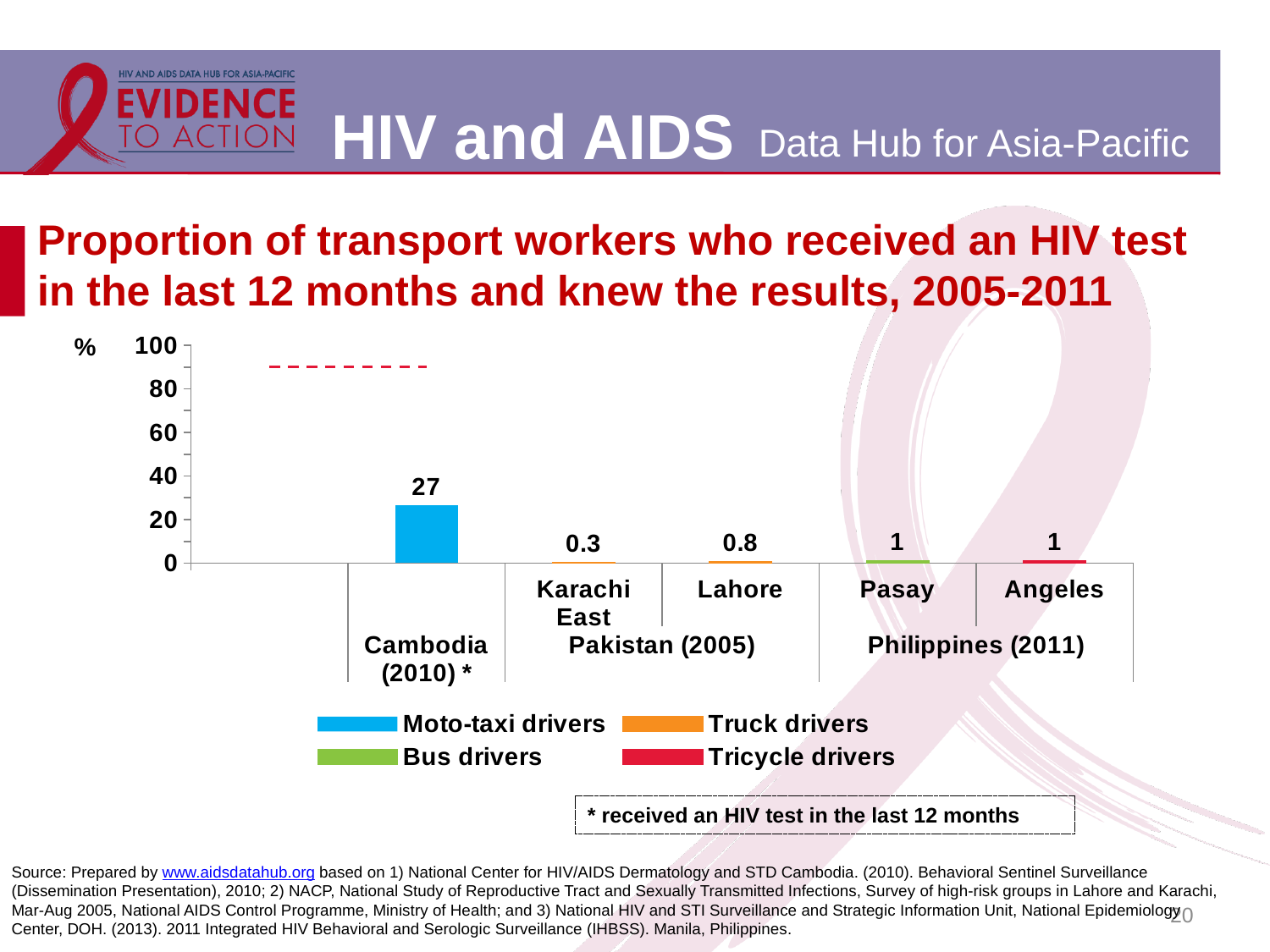
What is the value for Cambodia (2010)? 27 Which is larger, the value for Lahore or the value for Karachi East? Lahore What type of chart is shown on the slide? Bar chart How many locations are plotted on the chart? 5 Which location has the highest proportion of transport workers tested? Cambodia (2010) Which location has the lowest value on the chart? Karachi East How many series does the legend list? 4 What is the value for Lahore? 0.8 What is the value for Karachi East? 0.3 Is the value for Cambodia (2010) greater or less than 40? less What is the value for Pasay? 1 What is the difference between the values for Cambodia (2010) and Lahore? 26.2